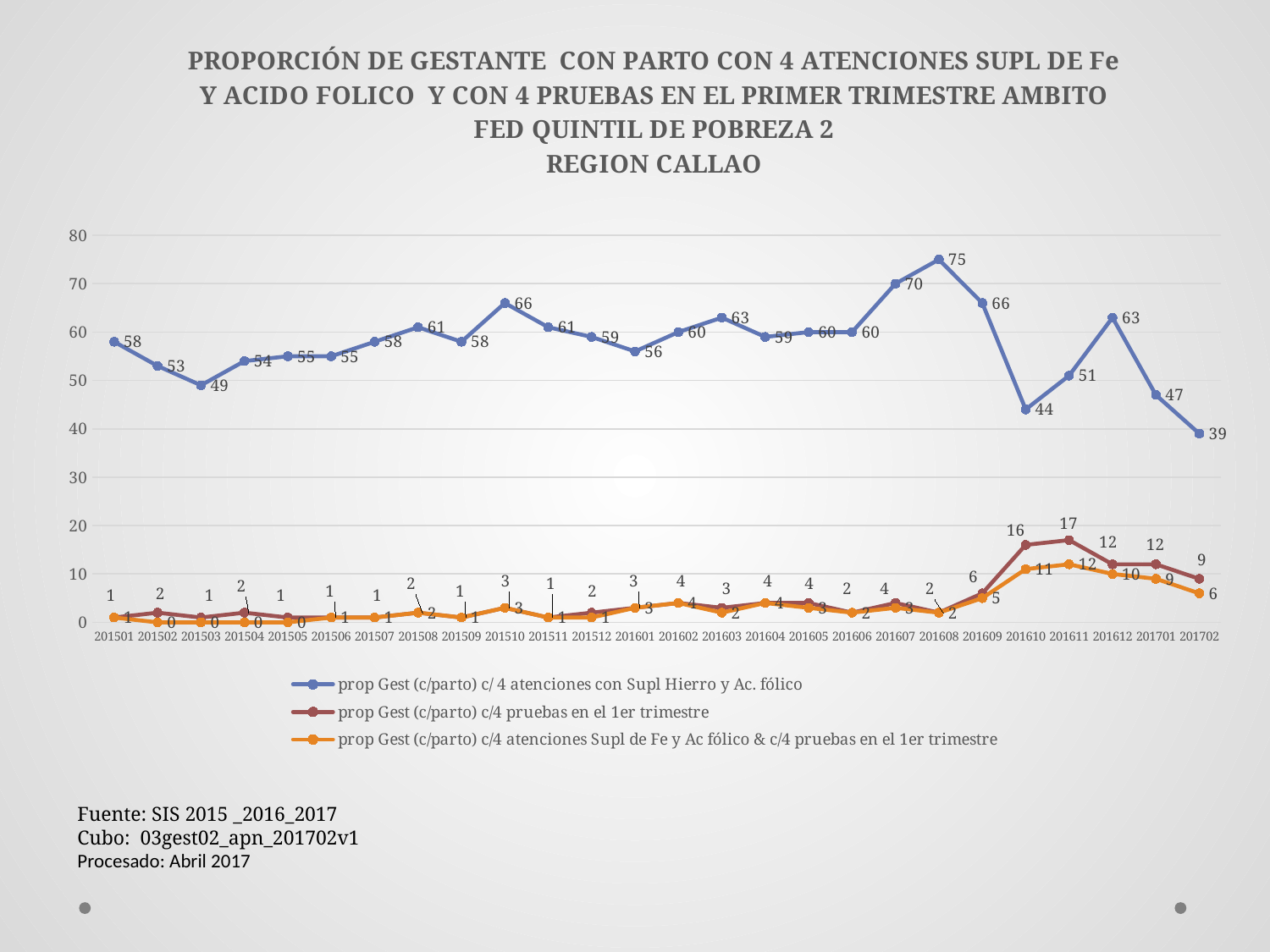
What is the value of the series 'prop Gest (c/parto) c/ 4 atenciones con Supl Hierro y Ac. fólico' at 201608? 75 What is the value of the series 'prop Gest (c/parto) c/4 pruebas en el 1er trimestre' at 201611? 17 What is the value of the series 'prop Gest (c/parto) c/4 atenciones Supl de Fe y Ac fólico & c/4 pruebas en el 1er trimestre' at 201610? 11 What is the difference between the values of the series 'prop Gest (c/parto) c/ 4 atenciones con Supl Hierro y Ac. fólico' at 201608 and at 201702? 36 In which period does the series 'prop Gest (c/parto) c/ 4 atenciones con Supl Hierro y Ac. fólico' reach its highest value? 201608 How many series does the legend list? 3 For the series 'prop Gest (c/parto) c/ 4 atenciones con Supl Hierro y Ac. fólico', which period has the larger value, 201610 or 201611? 201611 In which period does the series 'prop Gest (c/parto) c/ 4 atenciones con Supl Hierro y Ac. fólico' reach its lowest value? 201702 Does the series 'prop Gest (c/parto) c/ 4 atenciones con Supl Hierro y Ac. fólico' rise or fall from 201608 to 201610? fall How many time periods are plotted along the x axis? 26 Is the value of the series 'prop Gest (c/parto) c/ 4 atenciones con Supl Hierro y Ac. fólico' at 201610 greater or less than 50? less What kind of chart is shown on the slide? line chart